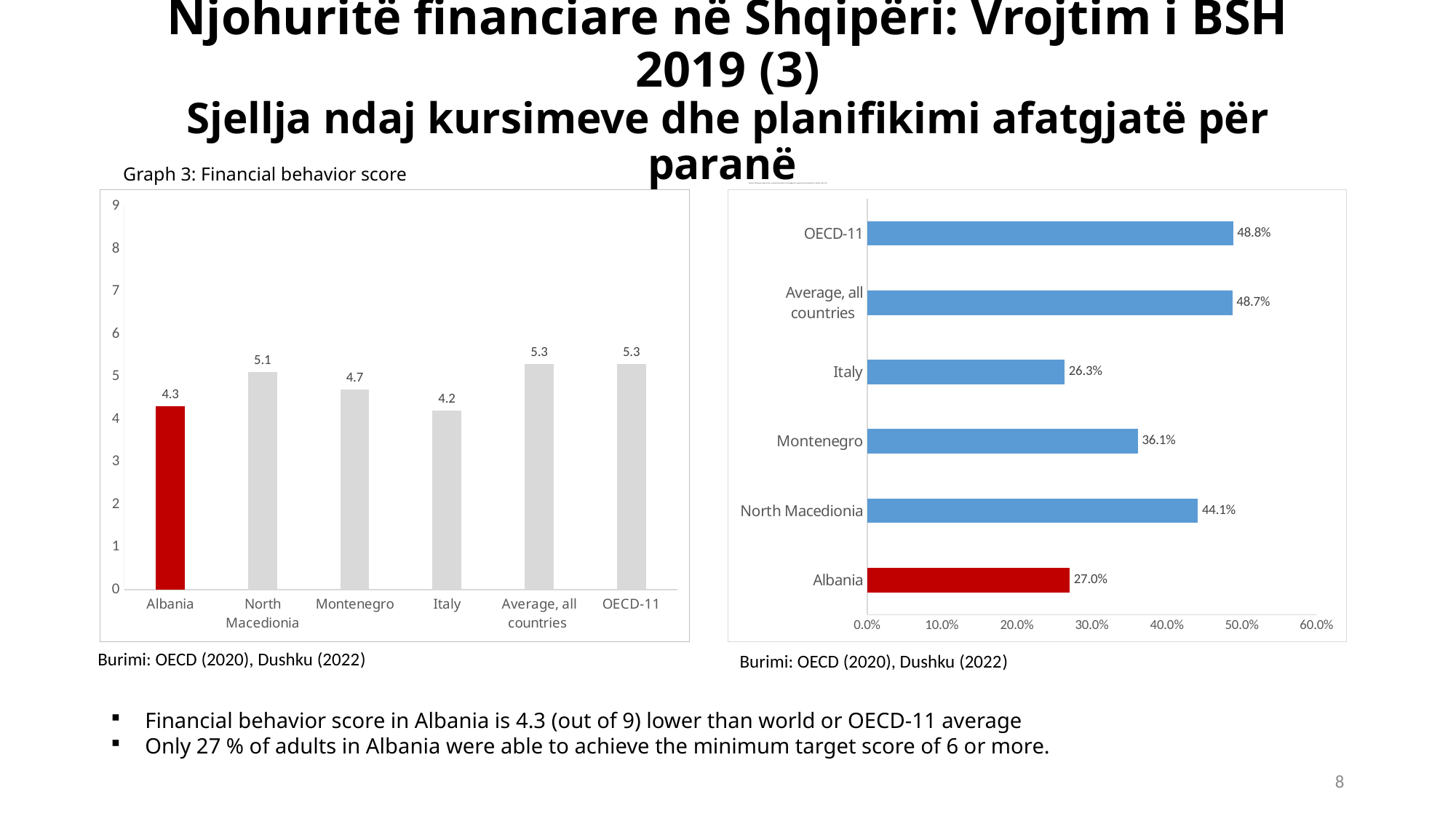
In Graph 3: Financial behavior score, which category has the lowest value? Italy In the horizontal bar chart on the right, which is larger, the value for North Macedonia or the value for Montenegro? North Macedonia In Graph 3: Financial behavior score, what is the difference between the value for North Macedonia and the value for Albania? 0.8 In the horizontal bar chart on the right, which category has the lowest value? Italy In the horizontal bar chart on the right, what is the difference between the value for OECD-11 and the value for Albania? 21.8% In the horizontal bar chart on the right, what is the value for Albania? 27.0% In the horizontal bar chart on the right, what is the value for Montenegro? 36.1% In Graph 3: Financial behavior score, which bar is coloured red? Albania In Graph 3: Financial behavior score, what is the value for Montenegro? 4.7 In Graph 3: Financial behavior score, how many categories are shown on the x axis? 6 In Graph 3: Financial behavior score, what kind of chart is shown? bar chart In Graph 3: Financial behavior score, what is the value for Albania? 4.3